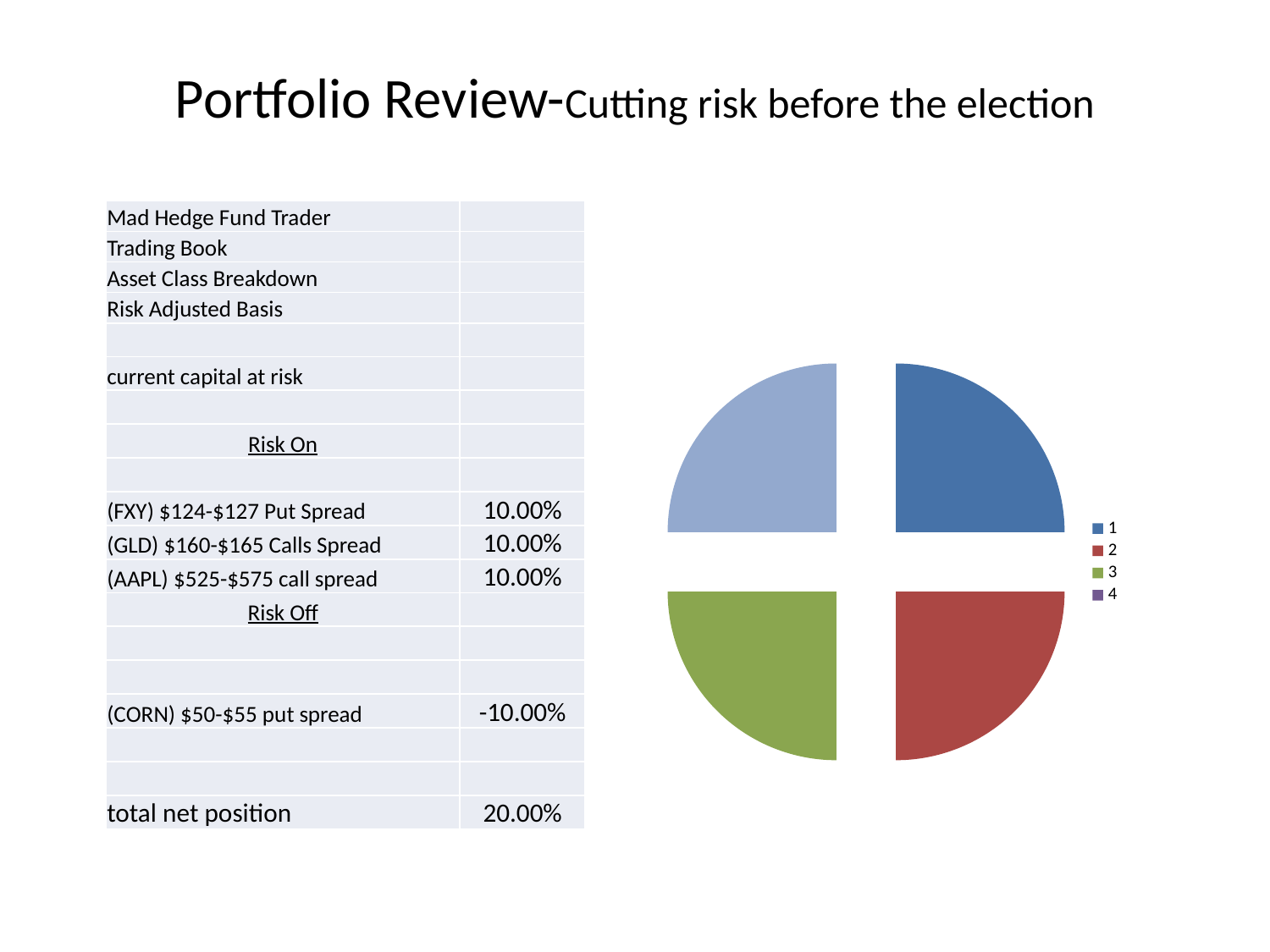
How many slices does the pie chart have? 4 What are the entries listed in the pie chart's legend? 1, 2, 3, 4 What kind of chart is shown on the slide? pie chart How many entries does the pie chart's legend list? 4 Do slices 1 and 2 of the pie chart appear to be the same size? yes What colour is slice 1 in the pie chart? blue